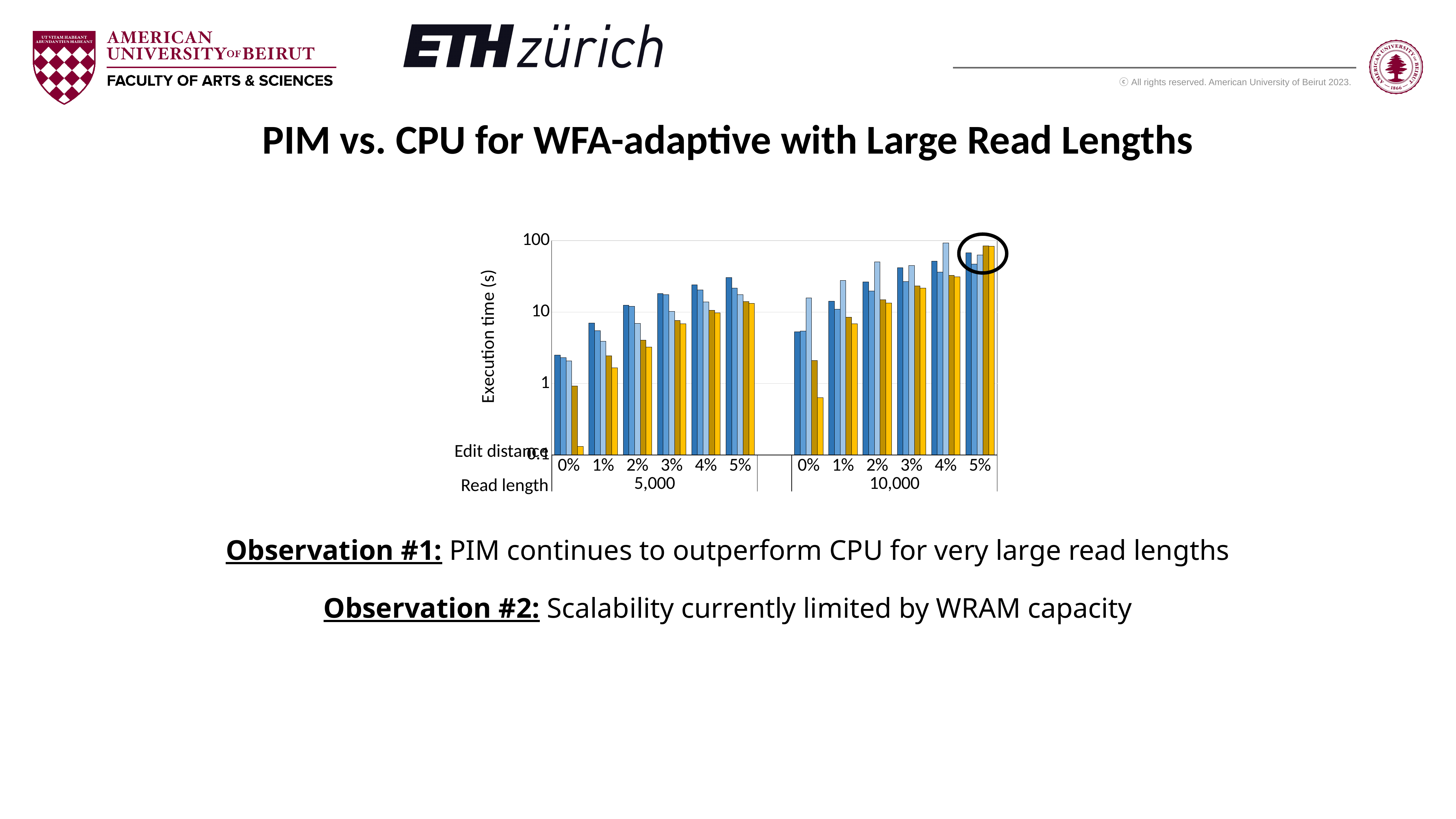
Is the tallest bar for 5% edit distance at read length 5,000 greater or less than 10? greater At 5% edit distance, which read length group has the taller bars: 5,000 or 10,000? 10,000 What is the label of the y axis of the chart? Execution time (s) What is the highest value shown on the y axis of the chart? 100 How many read length groups are shown on the x axis of the chart? 2 How many edit distance categories are shown for each read length in the chart? 6 Is the tallest bar for 0% edit distance at read length 5,000 greater or less than 10? less What is the title of the slide containing the chart? PIM vs. CPU for WFA-adaptive with Large Read Lengths Is the tallest bar for 5% edit distance at read length 10,000 greater or less than 10? greater For read length 5,000, do the execution times of the dark blue bars rise or fall as edit distance increases from 0% to 5%? rise What kind of chart is shown on the slide? bar chart